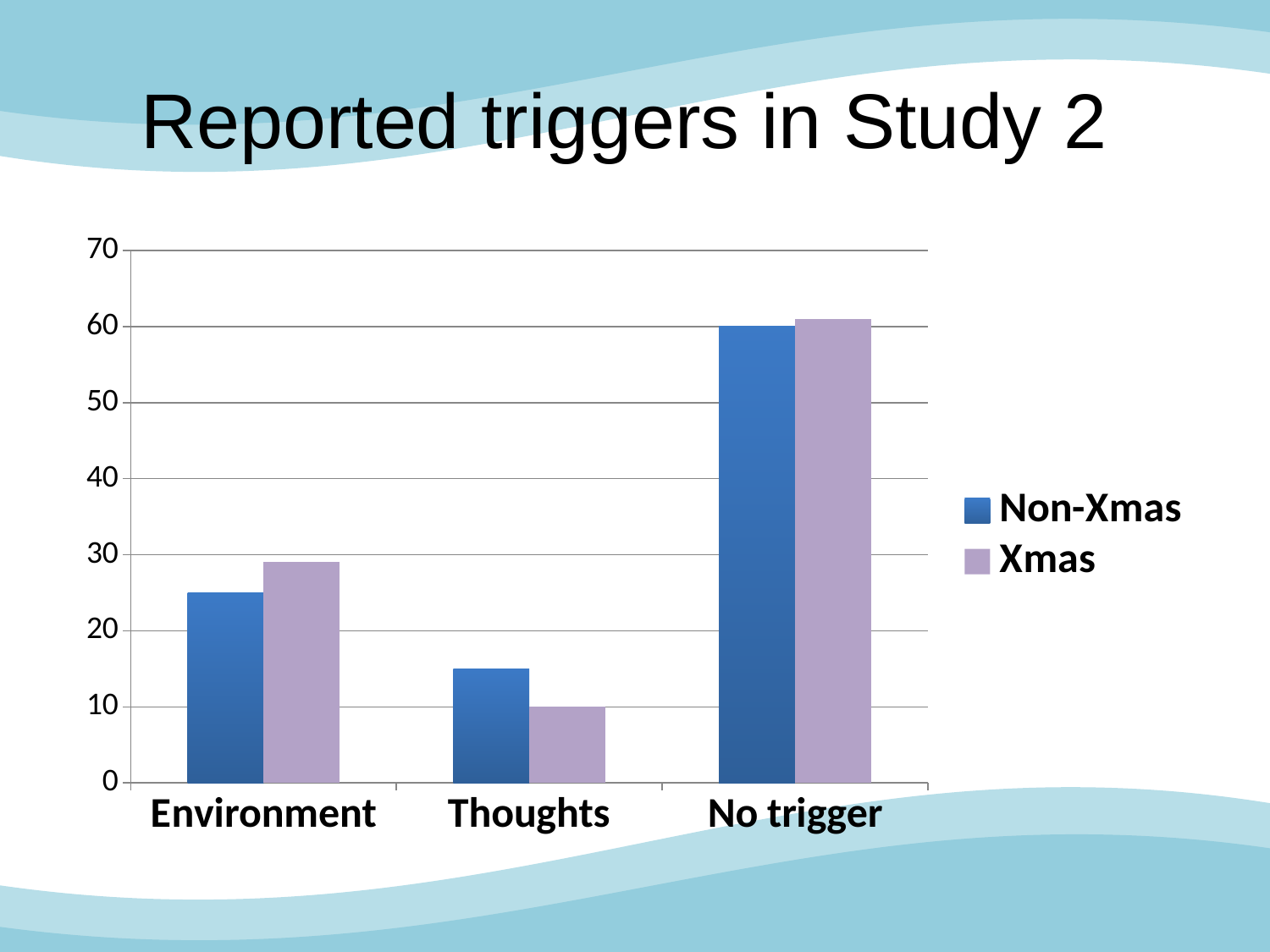
For Environment, which series has the larger value, Non-Xmas or Xmas? Xmas How many series does the legend list? 2 How many categories are shown on the x axis? 3 Is the Non-Xmas value for Environment greater or less than 20? greater What is the Non-Xmas value for No trigger? 60 Is the Non-Xmas value for Thoughts greater or less than 20? less For Thoughts, which series has the larger value, Non-Xmas or Xmas? Non-Xmas Which category has the lowest Xmas value? Thoughts What kind of chart is shown on the slide? bar chart Which category has the highest Non-Xmas value? No trigger What is the title of the chart? Reported triggers in Study 2 What is the Xmas value for Thoughts? 10